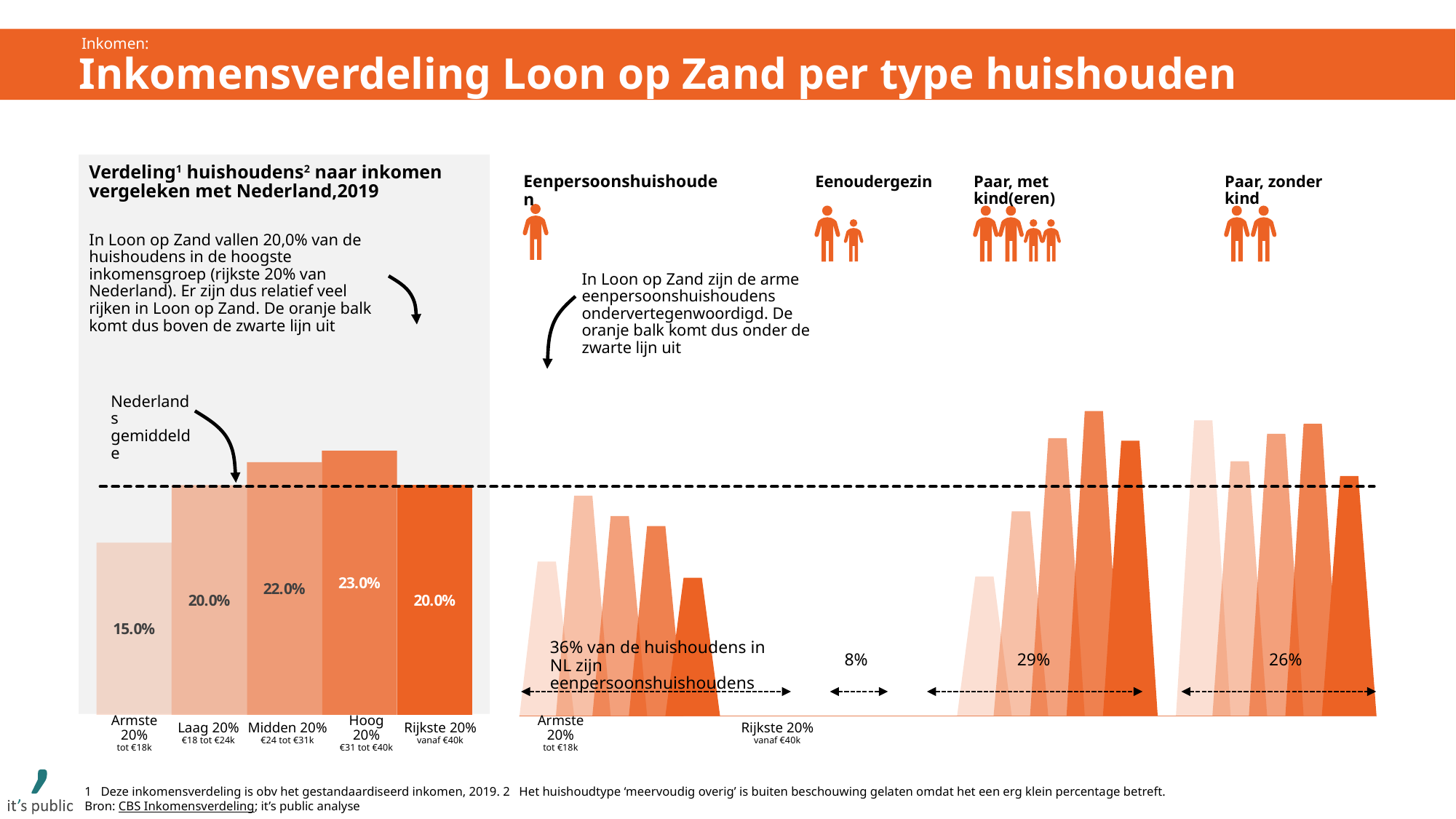
In the left chart, what is the value for Rijkste 20%? 20.0% In the right-hand chart, which household type has the largest share of households in NL? Eenpersoonshuishouden (36%) In the right-hand chart, what share of households in NL is Eenoudergezin? 8% In the left chart, which is larger: the value for Midden 20% or for Laag 20%? Midden 20% In the left chart, which income group has the lowest value? Armste 20% In the left chart, what is the difference between the values for Hoog 20% and Armste 20%? 8.0 percentage points In the left chart, which income group has the highest value? Hoog 20% In the left chart, what does the dashed black line represent? Nederlands gemiddelde In the left chart 'Verdeling huishoudens naar inkomen vergeleken met Nederland, 2019', what is the value for Armste 20%? 15.0% What kind of chart is the left chart? Bar chart In the left chart, what is the value for Hoog 20%? 23.0% How many income groups are shown in the left chart? 5